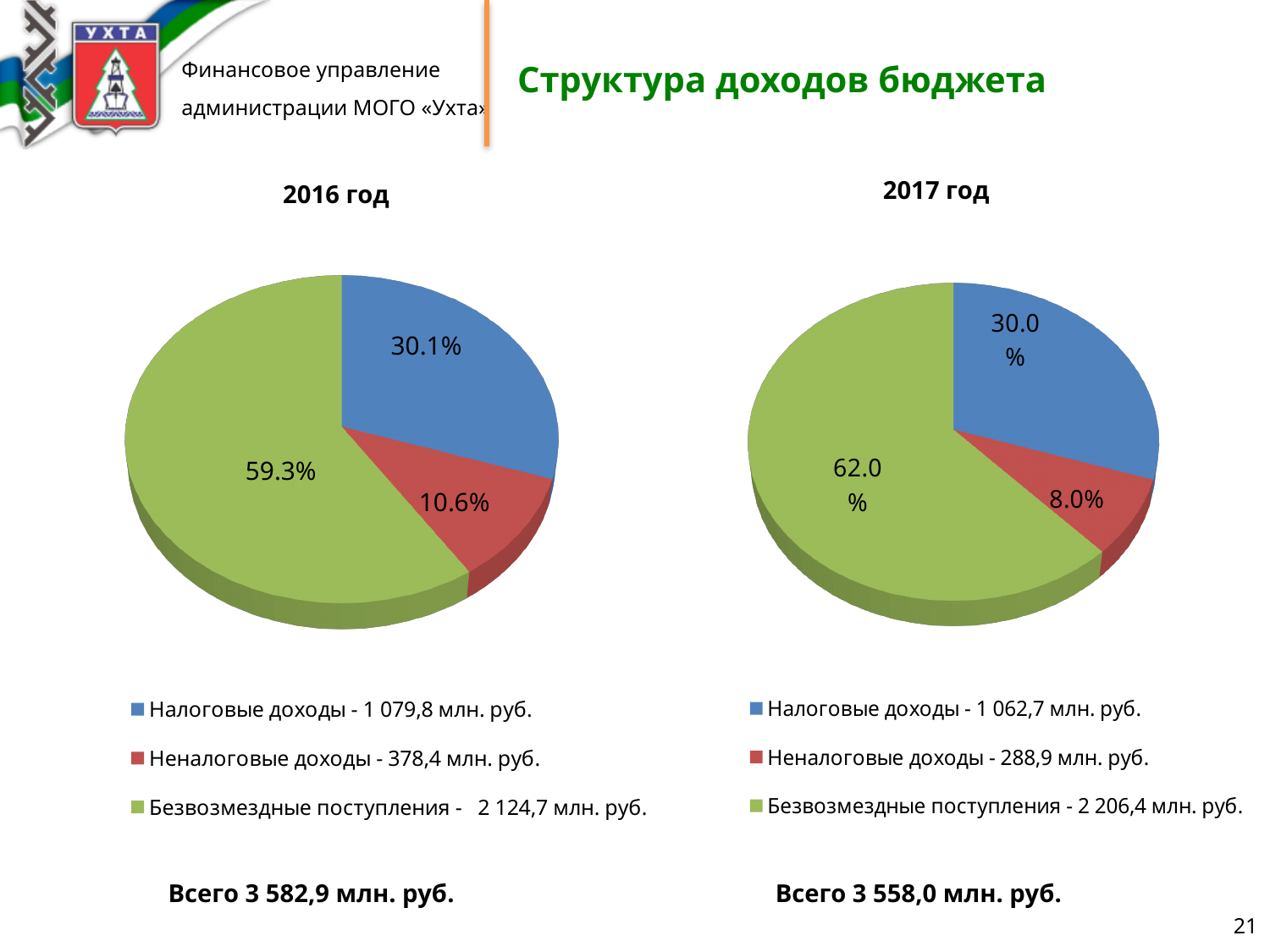
What type of chart is used for the 2016 год data? Pie chart In the 2016 год pie chart, what share is shown for Безвозмездные поступления? 59.3% In the 2016 год pie chart, which category has the smallest slice? Неналоговые доходы In the 2017 год pie chart, what share is shown for Безвозмездные поступления? 62.0% In the 2016 год pie chart, what is the difference in percentage points between the Безвозмездные поступления slice and the Налоговые доходы slice? 29.2 In the 2017 год pie chart, what share is shown for Неналоговые доходы? 8.0% According to the legend of the 2017 год chart, what is the value of Налоговые доходы? 1 062,7 млн. руб. In the 2017 год pie chart, which category has the largest slice? Безвозмездные поступления Which is larger: the Неналоговые доходы share in 2016 год or in 2017 год? 2016 год How many slices does the 2017 год pie chart have? 3